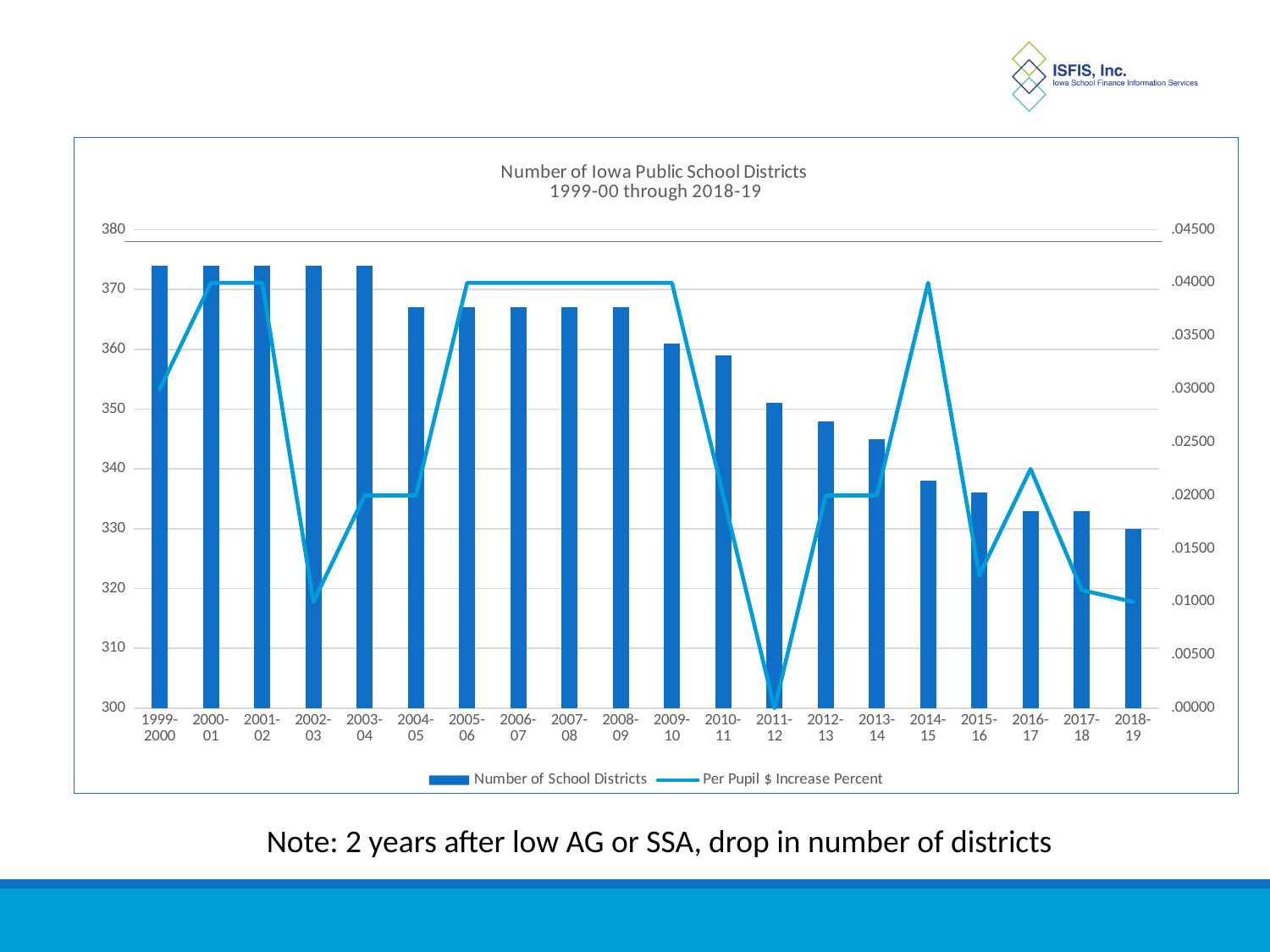
Which is larger, the Number of School Districts for 2009-10 or for 2013-14? 2009-10 Overall, does the Number of School Districts rise or fall from 1999-2000 to 2018-19? Fall Is the Number of School Districts for 1999-2000 greater or less than 370? greater How many school years are shown along the x axis? 20 Is the Number of School Districts for 2015-16 greater or less than 340? less How many series does the legend list? 2 Which is larger, the Per Pupil $ Increase Percent for 2014-15 or for 2015-16? 2014-15 In which school year does the Per Pupil $ Increase Percent line reach its lowest point? 2011-12 What is the title of the chart? Number of Iowa Public School Districts 1999-00 through 2018-19 Is the Number of School Districts for 2013-14 greater or less than 350? less Which school year has the lowest bar for Number of School Districts? 2018-19 What kind of chart is shown on the slide? A combined bar and line chart